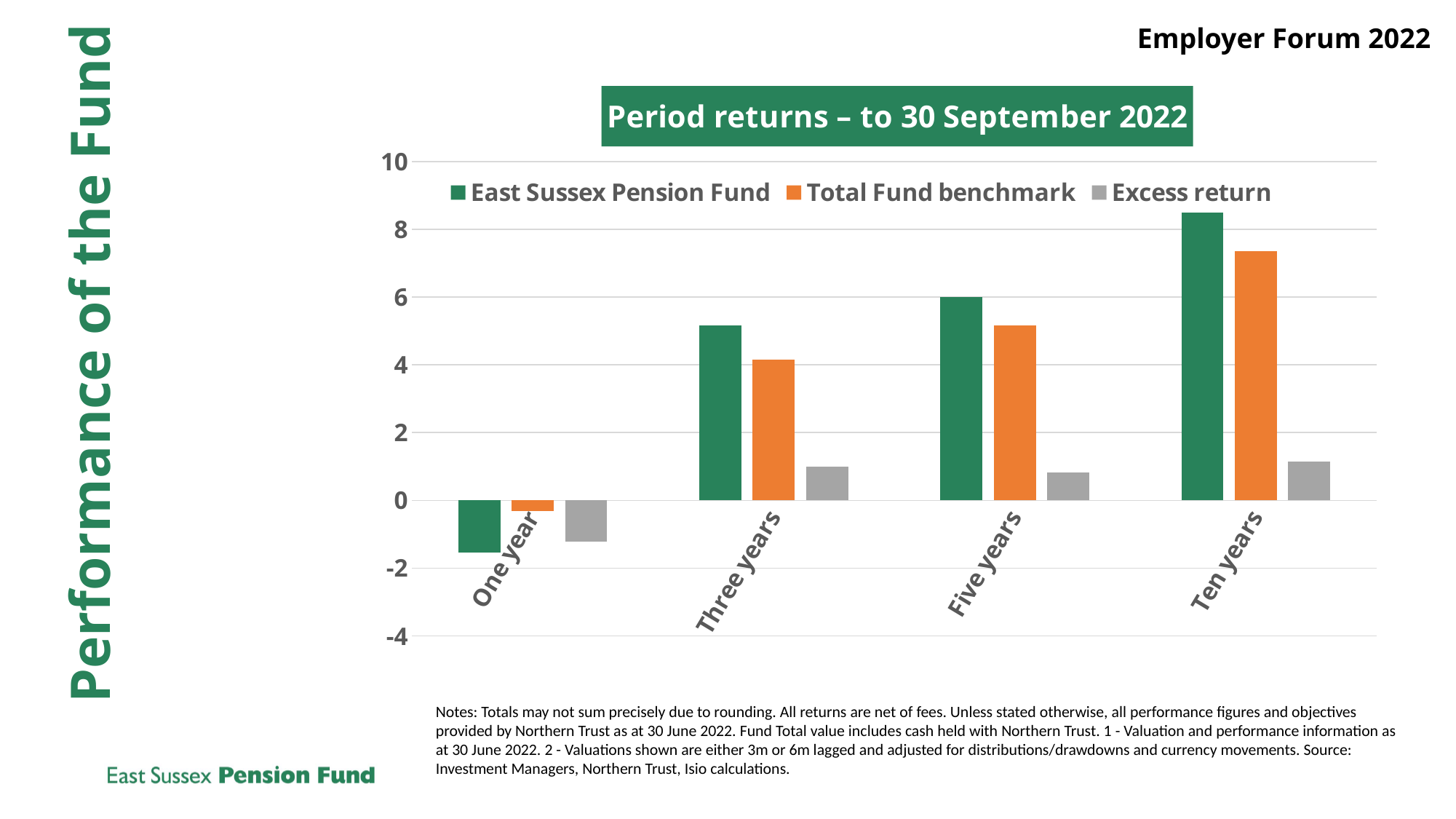
Do the East Sussex Pension Fund returns rise or fall from One year to Ten years? rise Is the East Sussex Pension Fund value for One year greater or less than 0? less How many series does the legend list? 3 What kind of chart is shown on the slide? bar chart For which period is the East Sussex Pension Fund return highest? Ten years How many period categories are shown on the x axis? 4 For Ten years, which is larger: the East Sussex Pension Fund return or the Total Fund benchmark? East Sussex Pension Fund Is the Total Fund benchmark value for Ten years greater or less than 8? less For which period is the East Sussex Pension Fund return lowest? One year What is the title of the chart? Period returns – to 30 September 2022 Is the East Sussex Pension Fund value for Ten years greater or less than 8? greater Which series is shown in orange? Total Fund benchmark